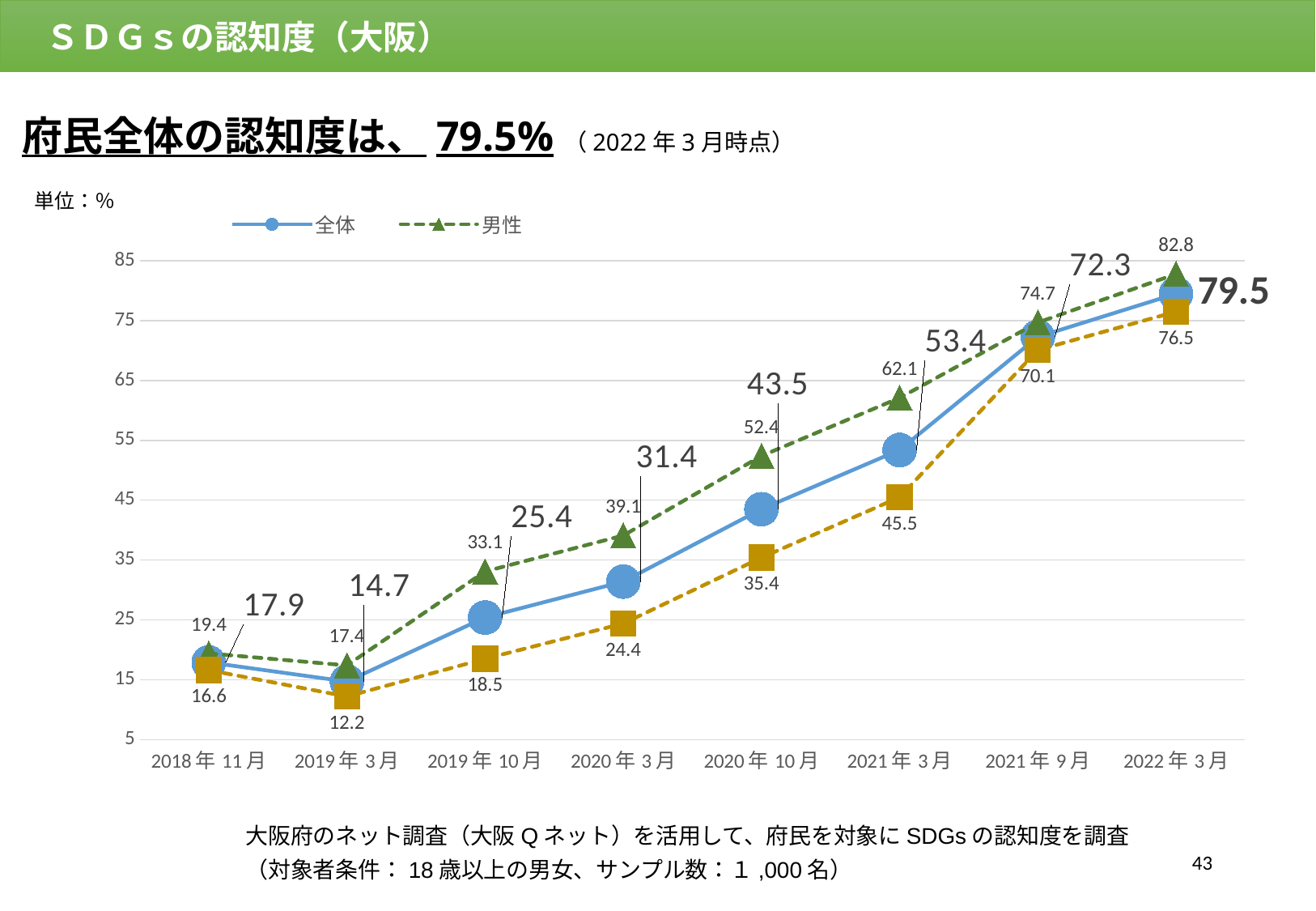
What is the difference between the 男性 value and the 全体 value in 2021年3月? 8.7 At which time point is the 全体 value lowest? 2019年3月 What is the value for 全体 in 2022年3月? 79.5 What is the value for 全体 in 2019年3月? 14.7 Which is larger in 2020年3月, the 全体 value or the 男性 value? 男性 What is the value for 男性 in 2020年10月? 52.4 What kind of chart is shown on the slide? line chart Is the 全体 value in 2021年9月 greater or less than 65? greater Does the 全体 value rise or fall from 2019年3月 to 2022年3月? rise At which time point is the 男性 value highest? 2022年3月 How many series does the legend list? 2 How many time points are shown on the x axis? 8